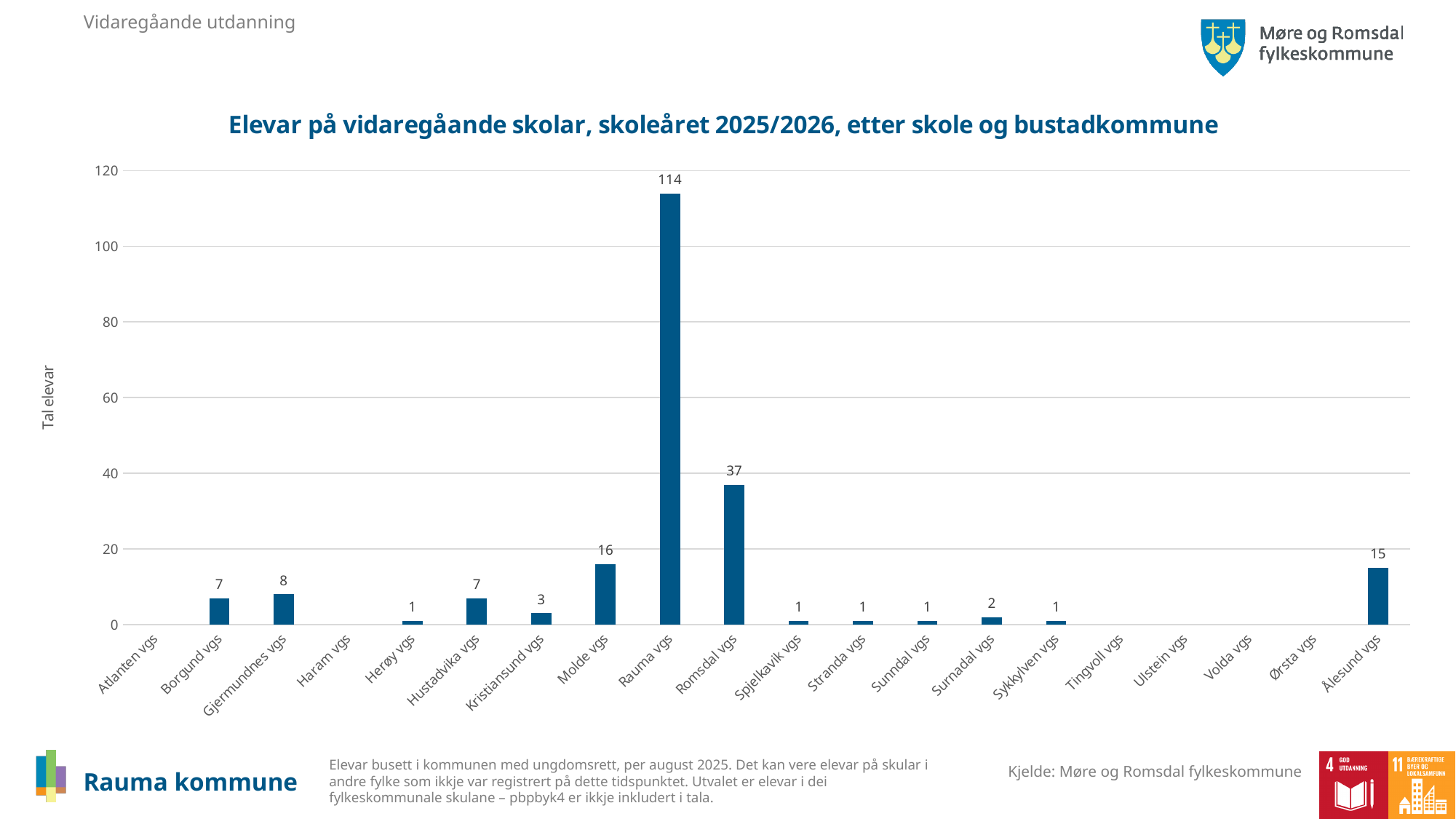
What kind of chart is shown on the slide? Bar chart What is the difference between the values for Molde vgs and Kristiansund vgs? 13 What is the value for Surnadal vgs? 2 What is the label on the vertical axis? Tal elevar What is the value for Romsdal vgs? 37 Which has a larger value, Molde vgs or Ålesund vgs? Molde vgs How many schools are listed on the x axis? 20 What is the difference between the values for Rauma vgs and Romsdal vgs? 77 Is the value for Rauma vgs greater or less than 100? greater How many students are shown for Rauma vgs? 114 What is the value for Gjermundnes vgs? 8 Which school has the highest number of students? Rauma vgs